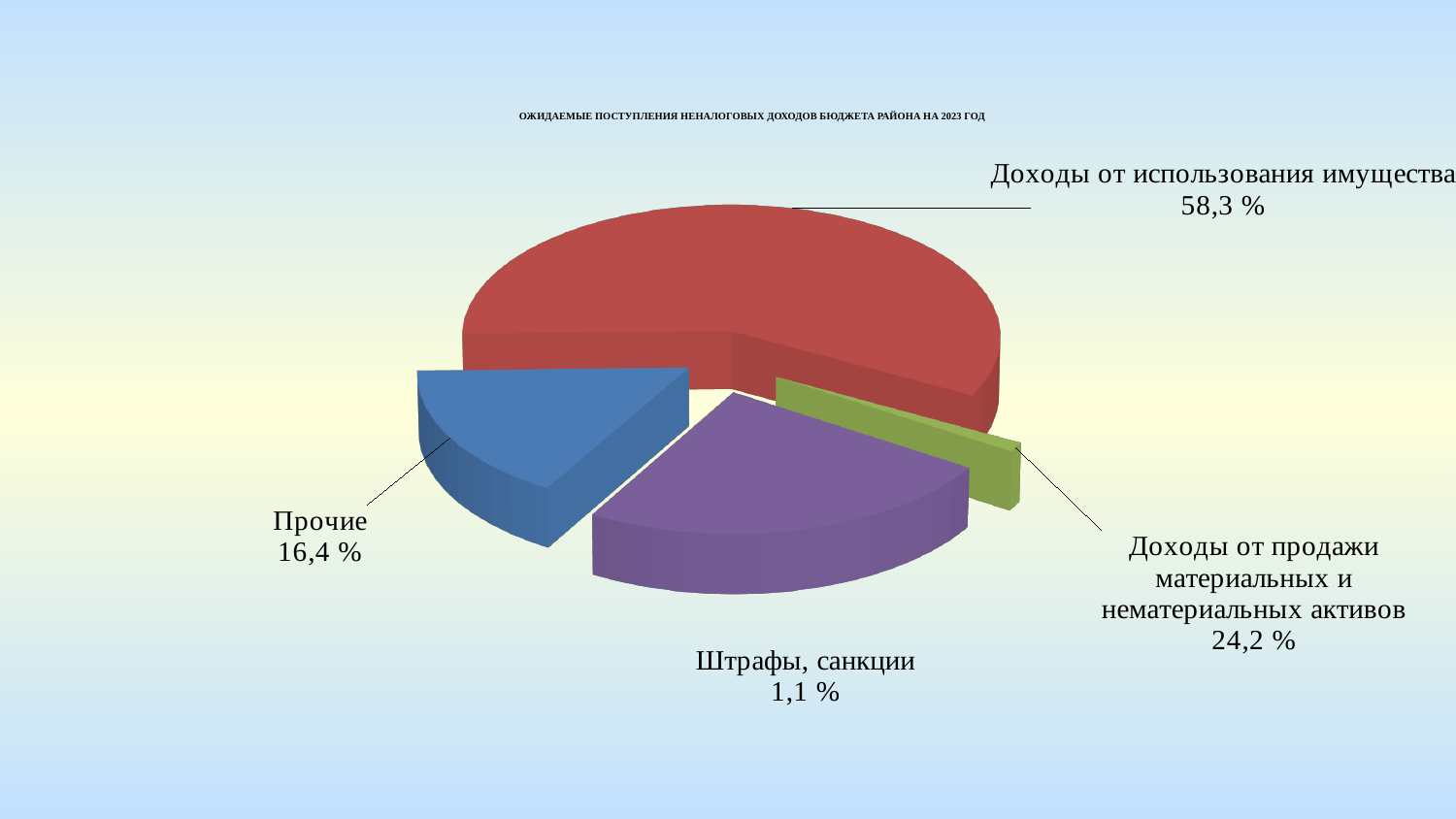
What share is shown for Доходы от использования имущества? 58,3 % Which is larger: the share for Прочие or the share for Доходы от продажи материальных и нематериальных активов? Доходы от продажи материальных и нематериальных активов How many categories are shown in the pie chart? 4 What year does the chart title refer to? 2023 What share is shown for Доходы от продажи материальных и нематериальных активов? 24,2 % What kind of chart is shown on the slide? pie chart What is the difference in percentage points between Доходы от использования имущества and Доходы от продажи материальных и нематериальных активов? 34,1 What share is shown for Прочие? 16,4 % What is the difference in percentage points between Прочие and Штрафы, санкции? 15,3 Which category has the largest share of the pie? Доходы от использования имущества Which category has the smallest share of the pie? Штрафы, санкции What share is shown for Штрафы, санкции? 1,1 %